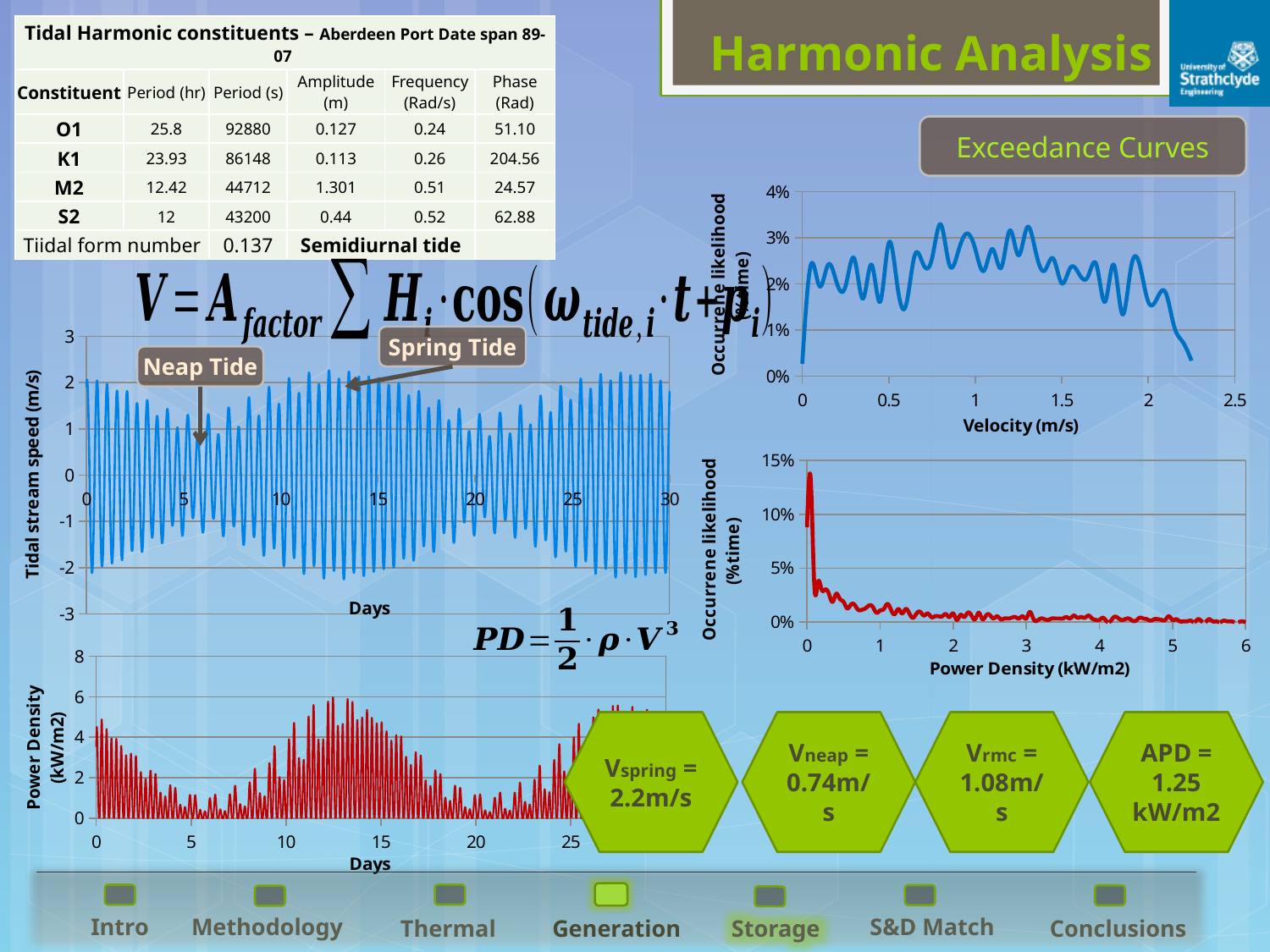
What colour is the line in the 'Power Density (kW/m2)' versus 'Days' chart at the bottom left? red What kind of chart is the exceedance curve of occurrence likelihood versus 'Velocity (m/s)' at the top right? line chart In the exceedance curve of occurrence likelihood versus 'Power Density (kW/m2)' at the bottom right, is the peak occurrence likelihood greater or less than 10%? greater In the exceedance curve of occurrence likelihood versus 'Velocity (m/s)' at the top right, is the peak occurrence likelihood greater or less than 2%? greater In the 'Tidal stream speed (m/s)' versus 'Days' chart, is the lowest tidal stream speed greater or less than -1 m/s? less How many charts are shown on the slide? 4 In the exceedance curve of occurrence likelihood versus 'Power Density (kW/m2)', does the occurrence likelihood generally rise or fall as power density increases? fall What kind of chart is the 'Tidal stream speed (m/s)' versus 'Days' chart on the left of the slide? line chart